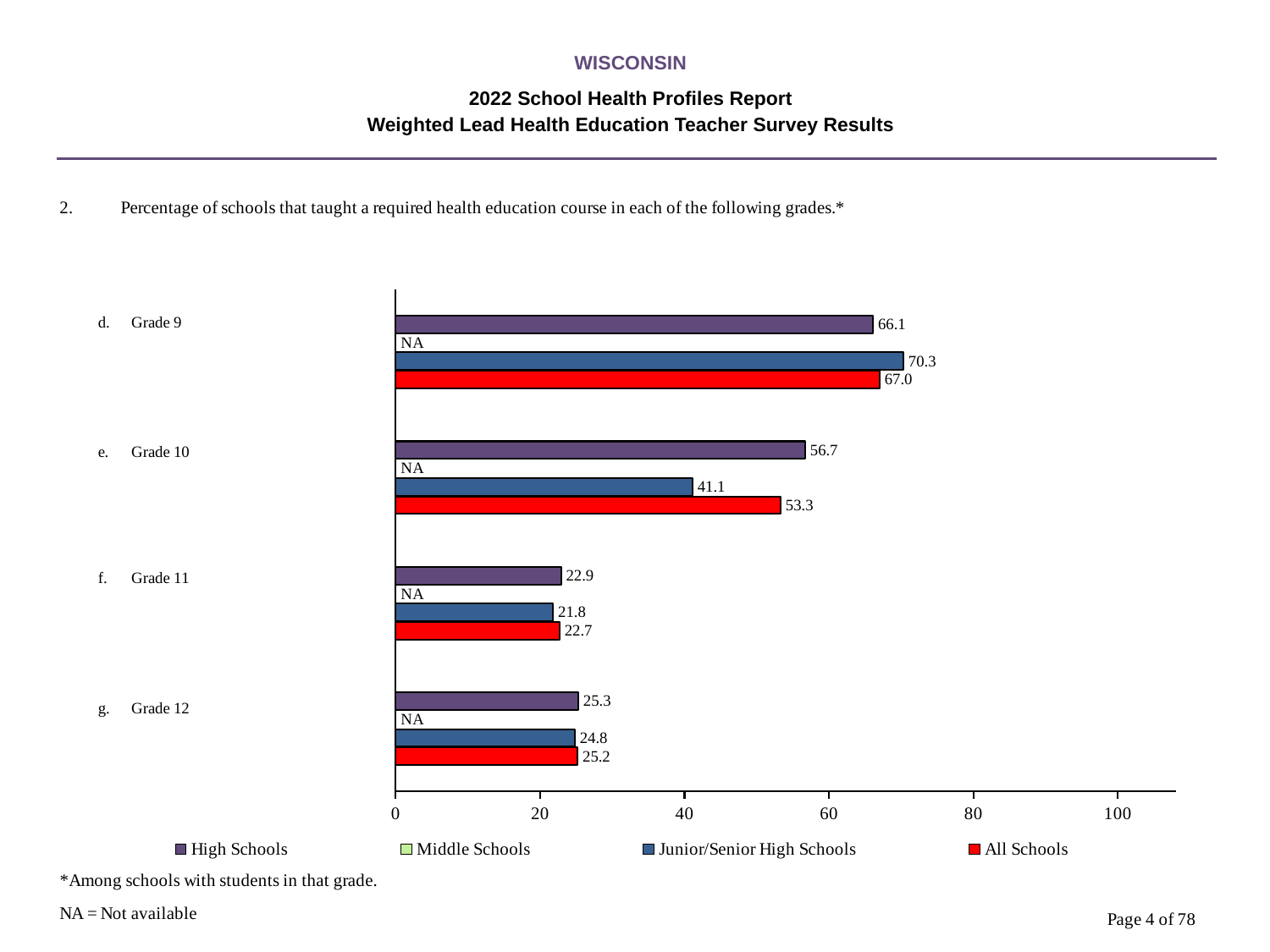
Which grade has the lowest value for High Schools? Grade 11 Which is larger for Grade 9: the High Schools value or the Junior/Senior High Schools value? Junior/Senior High Schools What is the value for Middle Schools for Grade 11? NA What kind of chart is shown on the slide? Bar chart How many series does the legend list? 4 Which grade has the highest value for All Schools? Grade 9 What is the value for High Schools for Grade 9? 66.1 What is the difference between the High Schools and Junior/Senior High Schools values for Grade 10? 15.6 What is the value for Junior/Senior High Schools for Grade 10? 41.1 What is the value for All Schools for Grade 12? 25.2 How many grade categories are shown on the chart? 4 Is the All Schools value for Grade 10 greater or less than 40? greater